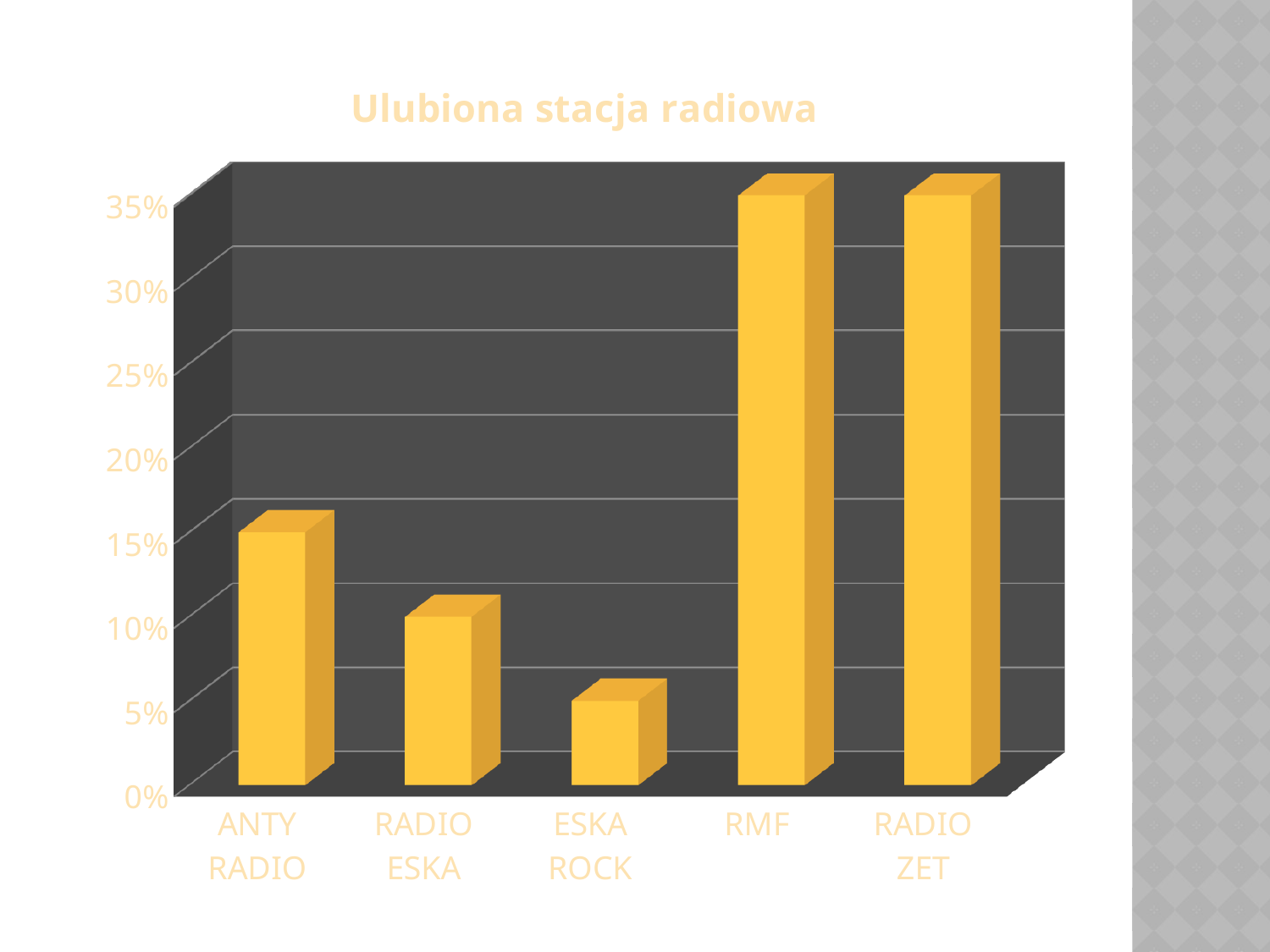
What type of chart is shown on the slide? bar chart What is the value for ANTY RADIO? 15% Is the value for RADIO ZET greater or less than 25%? greater Which has a larger value, ANTY RADIO or RADIO ESKA? ANTY RADIO What is the title of the chart? Ulubiona stacja radiowa Which radio station has the lowest value in the chart? ESKA ROCK What is the value for ESKA ROCK? 5% Which has a larger value, RMF or ESKA ROCK? RMF What is the value for RADIO ESKA? 10% Is the value for RMF greater or less than 30%? greater Is the value for ESKA ROCK greater or less than 10%? less How many radio stations are shown on the x axis of the chart? 5